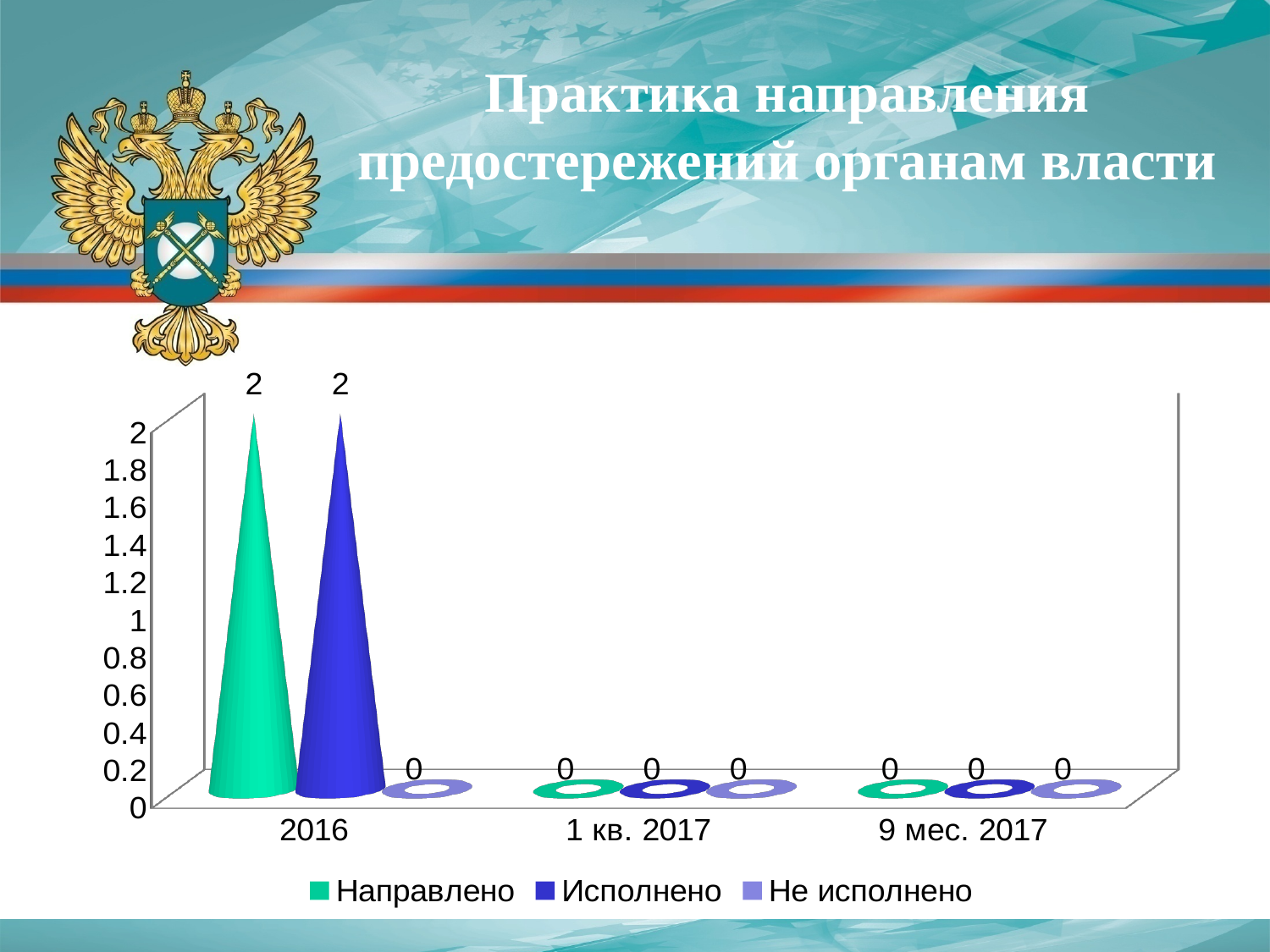
Which category has the highest value for Направлено? 2016 What is the value for Направлено in 1 кв. 2017? 0 Does the value for Исполнено rise or fall from 2016 to 9 мес. 2017? Fall What is the difference between Направлено and Не исполнено in 2016? 2 What is the value for Исполнено in 9 мес. 2017? 0 How many categories are shown on the x axis? 3 What kind of chart is shown on the slide? Bar chart What is the value for Не исполнено in 2016? 0 What is the value for Исполнено in 2016? 2 How many series does the legend list? 3 What is the value for Направлено in 2016? 2 Is the value for Направлено in 2016 larger than the value for Направлено in 9 мес. 2017? Yes